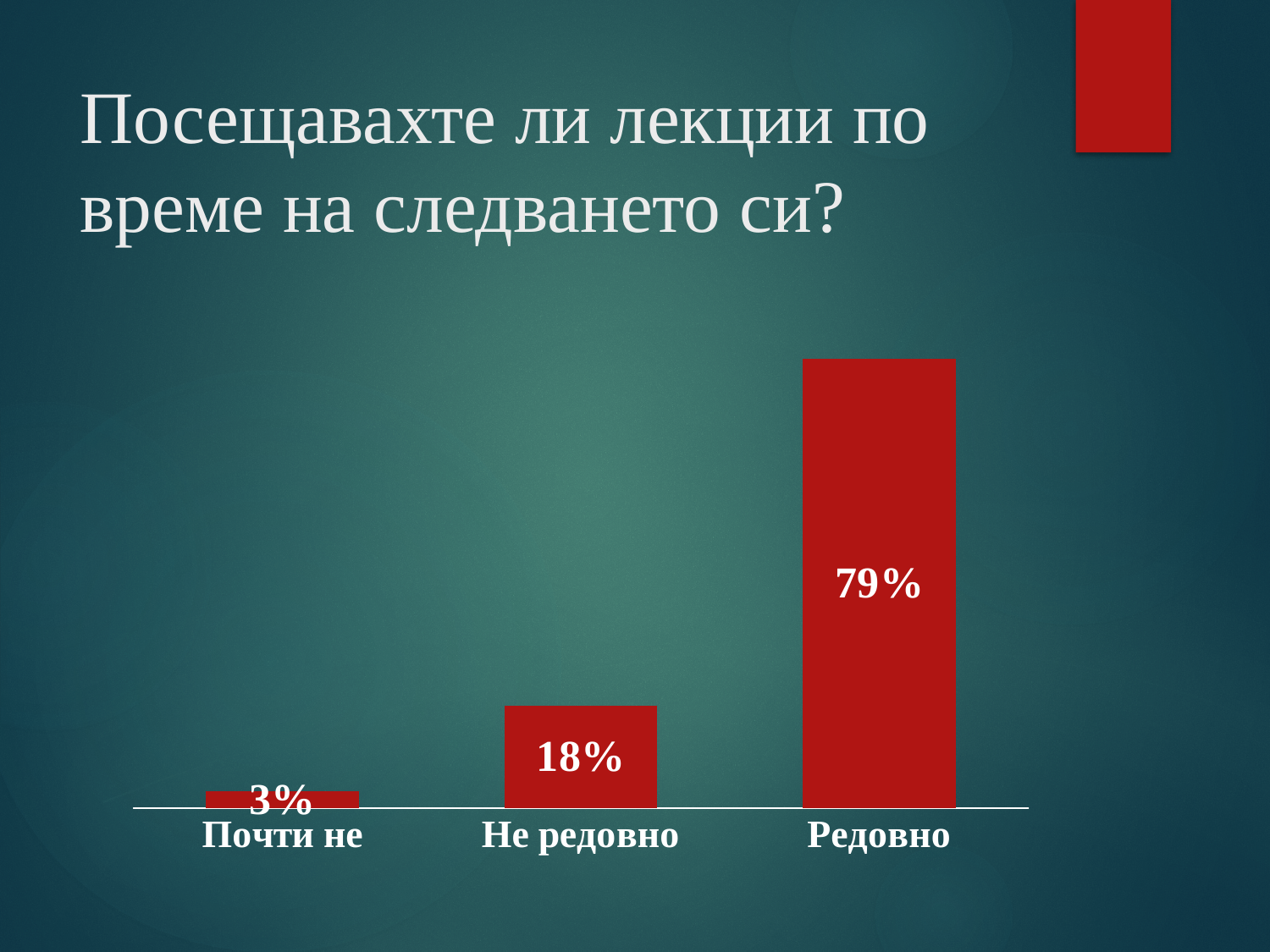
What is the difference between the values for Не редовно and Почти не? 15% What is the value for Редовно? 79% What is the value for Не редовно? 18% What is the value for Почти не? 3% Which is larger, the value for Не редовно or the value for Почти не? Не редовно Which category has the lowest value? Почти не Which category has the highest value? Редовно Do the values rise or fall from left to right along the x axis? rise How many categories are shown in the chart? 3 What is the difference between the values for Редовно and Не редовно? 61% What kind of chart is shown on the slide? bar chart What is the title of the slide containing the chart? Посещавахте ли лекции по време на следването си?